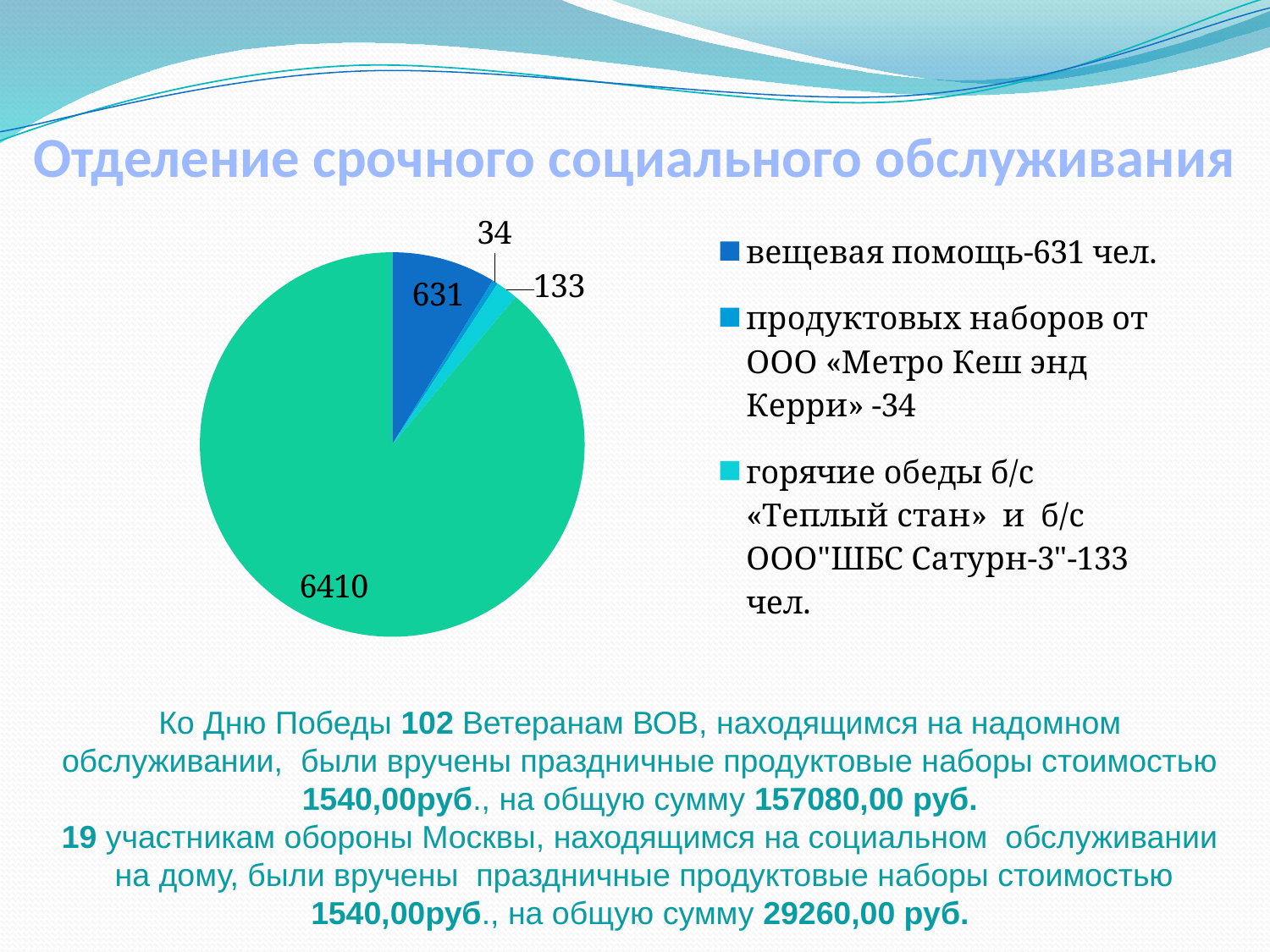
Which is larger: the slice for вещевая помощь or the slice for горячие обеды? вещевая помощь What is the value of the slice for вещевая помощь? 631 What is the difference between the горячие обеды slice (133) and the продуктовых наборов slice (34)? 99 What is the value of the slice for продуктовых наборов от ООО «Метро Кеш энд Керри»? 34 What is the title of the slide containing the pie chart? Отделение срочного социального обслуживания How many slices does the pie chart have? 4 Which legend category has the smallest slice in the pie chart? продуктовых наборов от ООО «Метро Кеш энд Керри» What is the difference between the вещевая помощь slice and the горячие обеды slice? 498 What kind of chart is shown on the slide? pie chart What is the value of the slice for горячие обеды б/с «Теплый стан» и б/с ООО"ШБС Сатурн-3"? 133 What is the value printed on the largest slice of the pie chart? 6410 How many entries does the legend list? 3